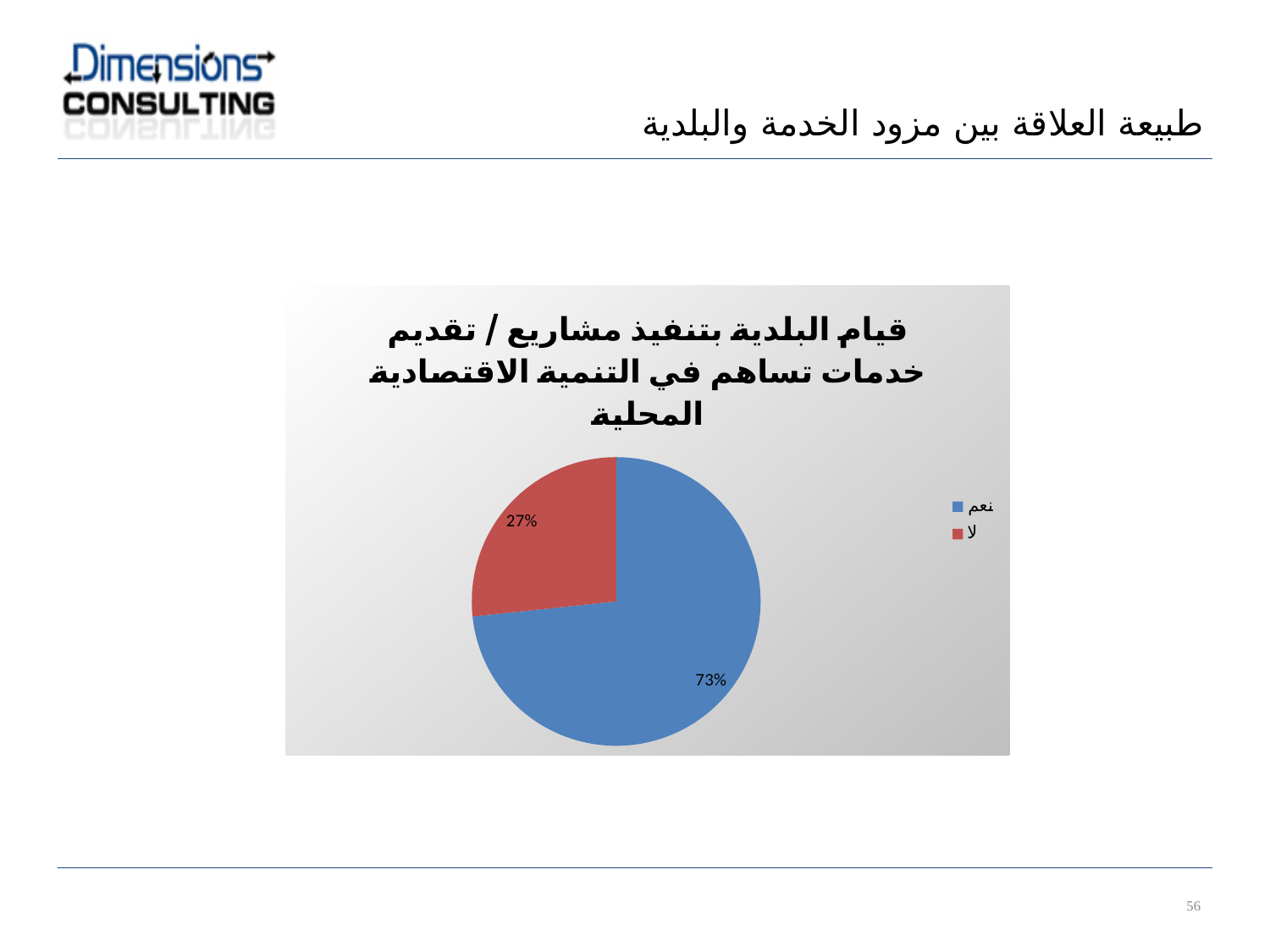
How many slices does the pie chart have? 2 What is the difference in percentage points between the نعم and لا slices? 46 What percentage of the pie is labelled نعم? 73% Which category has the smallest share of the pie? لا How many entries does the legend list? 2 What colour is the slice for لا? red Which slice is larger, نعم or لا? نعم What is the share of the pie taken by the لا slice? 27% What type of chart is shown on the slide? pie chart What colour is the slice for نعم? blue Which category has the largest share of the pie? نعم What percentage of the pie is labelled لا? 27%